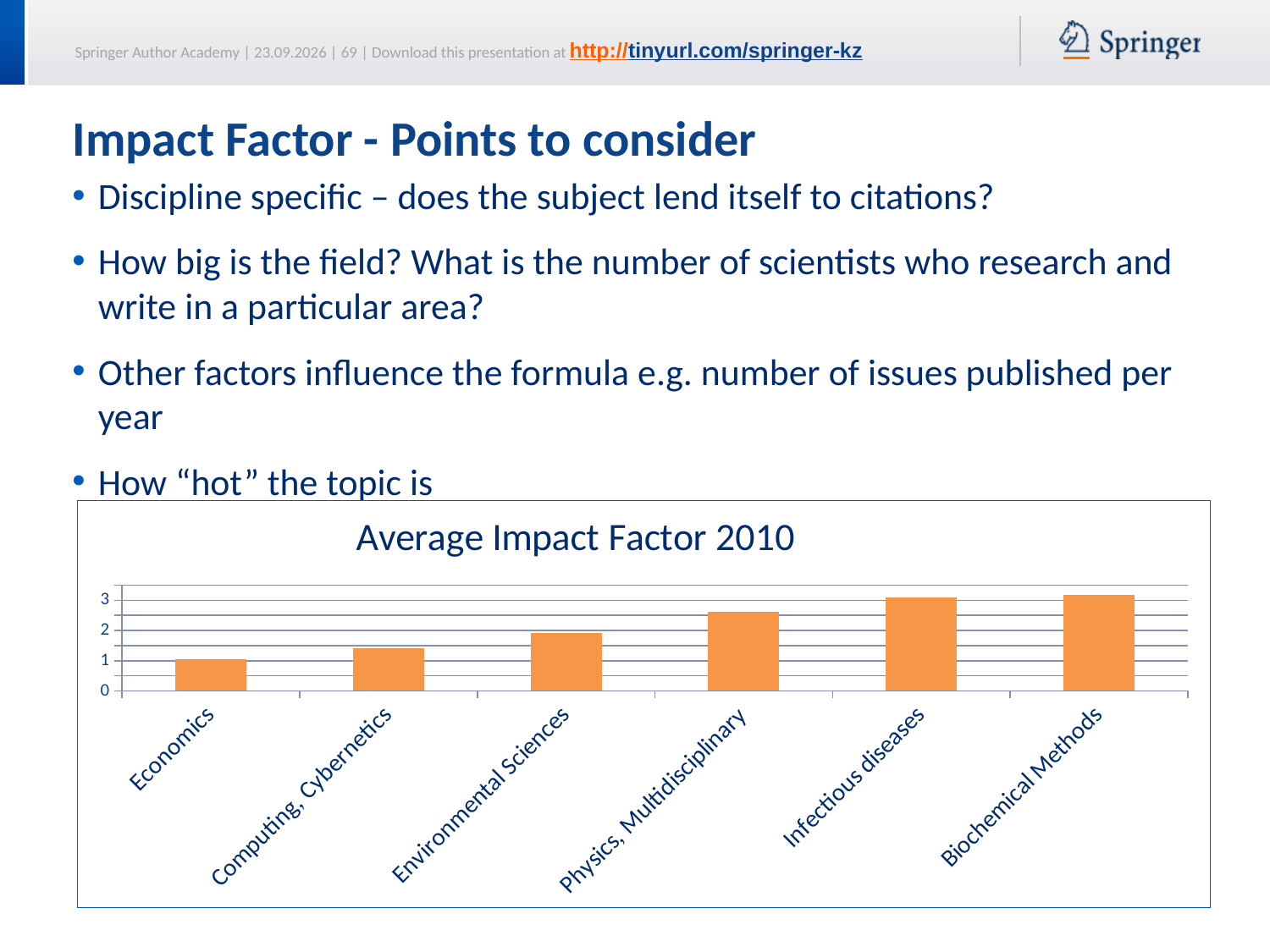
Is the value for Economics greater or less than 2? less Which category has the lowest average impact factor? Economics Is the value for Biochemical Methods greater or less than 2? greater Do the values rise or fall from left to right along the x axis? rise How many categories are plotted in the chart? 6 What kind of chart is shown on the slide? bar chart What is the title of the chart? Average Impact Factor 2010 Which has the larger value, Economics or Physics, Multidisciplinary? Physics, Multidisciplinary Which has the larger value, Computing, Cybernetics or Environmental Sciences? Environmental Sciences Is the value for Physics, Multidisciplinary greater or less than 2? greater